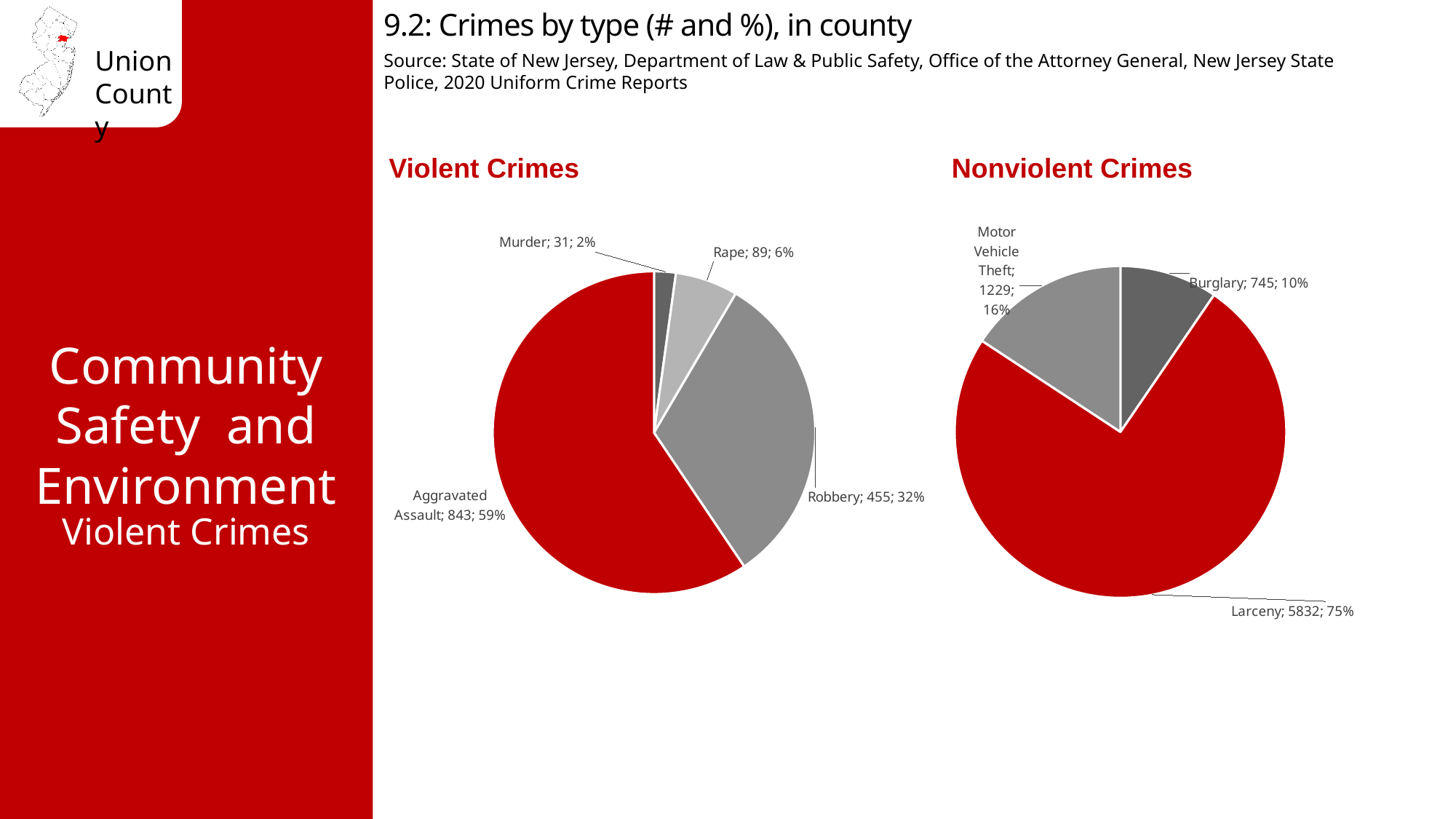
In the Nonviolent Crimes pie chart, which is larger, Motor Vehicle Theft or Burglary? Motor Vehicle Theft In the Violent Crimes pie chart, which category has the smallest slice? Murder What type of chart is used for the Violent Crimes data? Pie chart In the Violent Crimes pie chart, how many categories are shown? 4 In the Violent Crimes pie chart, what is the difference between the number of robberies and the number of rapes? 366 In the Violent Crimes pie chart, which category has the largest slice? Aggravated Assault In the Violent Crimes pie chart, what percentage share does Robbery have? 32% In the Nonviolent Crimes pie chart, what is the difference between the number of motor vehicle thefts and burglaries? 484 In the Nonviolent Crimes pie chart, what percentage share does Motor Vehicle Theft have? 16% In the Nonviolent Crimes pie chart, how many larcenies are shown? 5832 In the Nonviolent Crimes pie chart, which category has the smallest slice? Burglary In the Violent Crimes pie chart, how many aggravated assaults are shown? 843